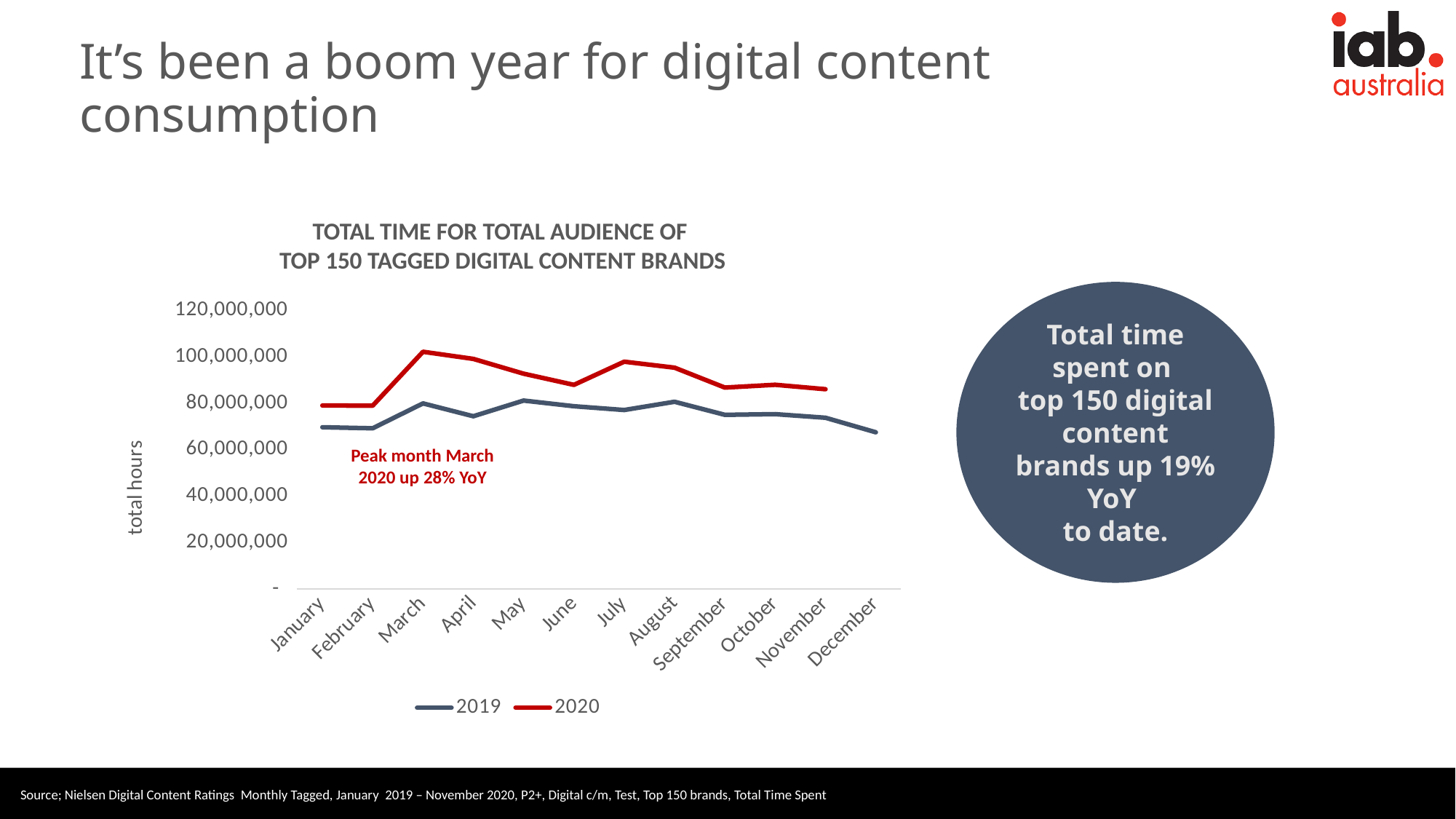
What kind of chart is shown on the slide? line chart How many series does the legend list? 2 In March, which series has the larger value, 2019 or 2020? 2020 Does the 2019 series rise or fall from September to December? fall What is the title of the chart? TOTAL TIME FOR TOTAL AUDIENCE OF TOP 150 TAGGED DIGITAL CONTENT BRANDS In which month does the 2020 series reach its highest value? March Is the 2020 value for November greater or less than 80,000,000? greater In which month is the 2019 series at its lowest value? December Is the 2020 value for January greater or less than 60,000,000? greater How many months are shown on the x axis? 12 Which series is drawn in red? 2020 Is the 2019 value for December greater or less than 80,000,000? less